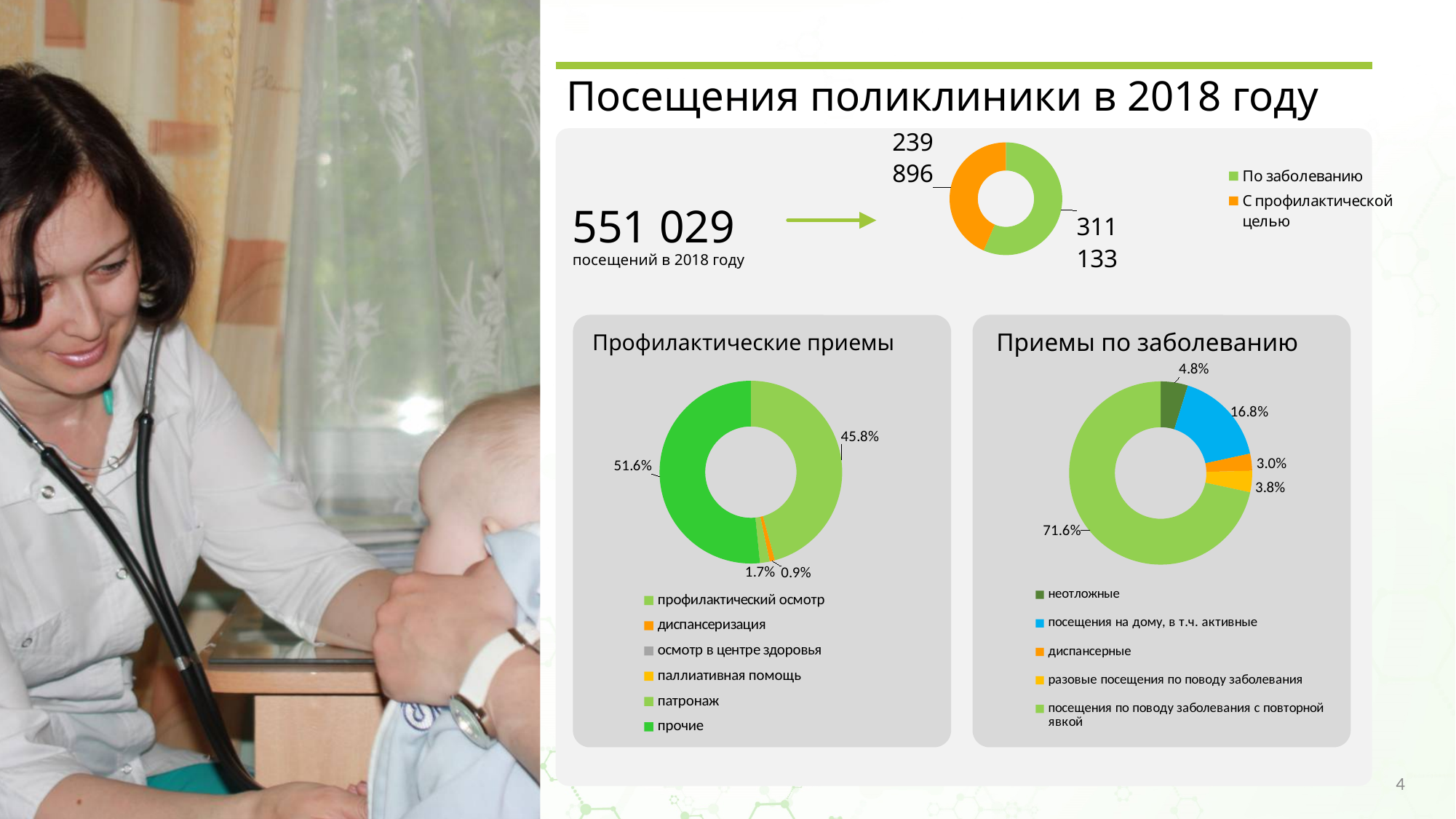
In the «Профилактические приемы» chart, what share is labelled for «профилактический осмотр»? 45.8% In the «Профилактические приемы» chart, what share is labelled for «прочие»? 51.6% What type of chart is used in the «Профилактические приемы» panel? Donut (pie) chart In the top donut chart, what is the difference between «По заболеванию» and «С профилактической целью»? 71 237 In the «Приемы по заболеванию» chart, which category has the largest share? посещения по поводу заболевания с повторной явкой In the «Приемы по заболеванию» chart, which category has the smallest share? диспансерные How many entries does the legend of the top donut chart list? 2 How many entries does the legend of the «Профилактические приемы» chart list? 6 In the top donut chart, what is the value for «С профилактической целью»? 239 896 In the «Приемы по заболеванию» chart, what share is labelled for «посещения на дому, в т.ч. активные»? 16.8% In the top donut chart, what is the value for «По заболеванию»? 311 133 In the top donut chart, which category is larger: «По заболеванию» or «С профилактической целью»? По заболеванию